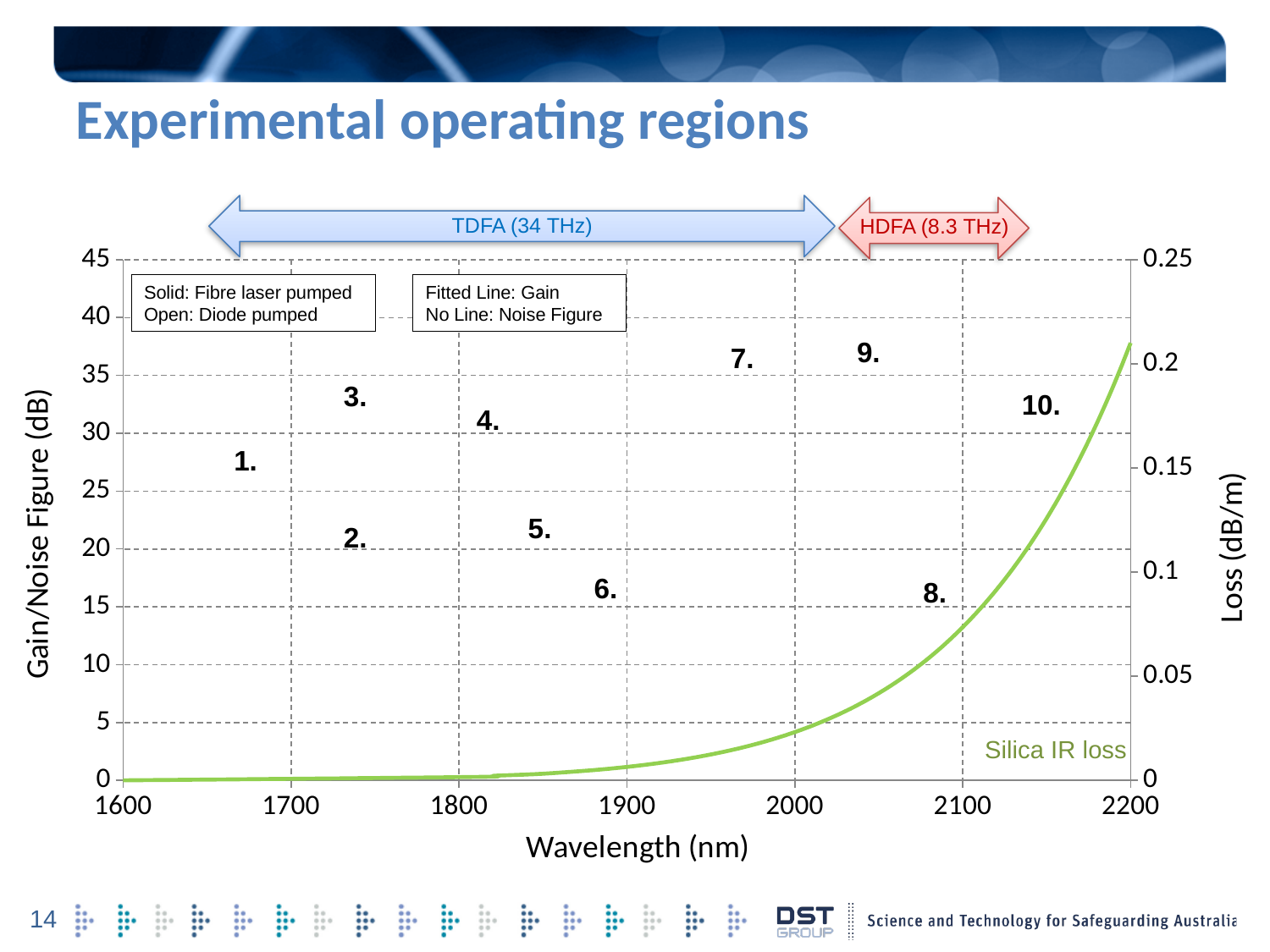
What kind of chart is shown on the slide? line chart Is the Silica IR loss value at 2100 nm greater or less than 0.1 dB/m? less Is the Silica IR loss value at 2000 nm greater or less than 0.05 dB/m? less Is the Silica IR loss value at 1800 nm greater or less than 0.05 dB/m? less Is the Silica IR loss higher at 2200 nm or at 2000 nm? 2200 nm What is the highest value shown on the left-hand Gain/Noise Figure (dB) axis? 45 Does the Silica IR loss line rise or fall as wavelength increases from 1600 nm to 2200 nm? rise What is the title of the x axis of the chart? Wavelength (nm) What is the highest value shown on the right-hand Loss (dB/m) axis? 0.25 How many numbered experimental operating regions are marked on the chart? 10 What is the label of the green line plotted on the chart? Silica IR loss